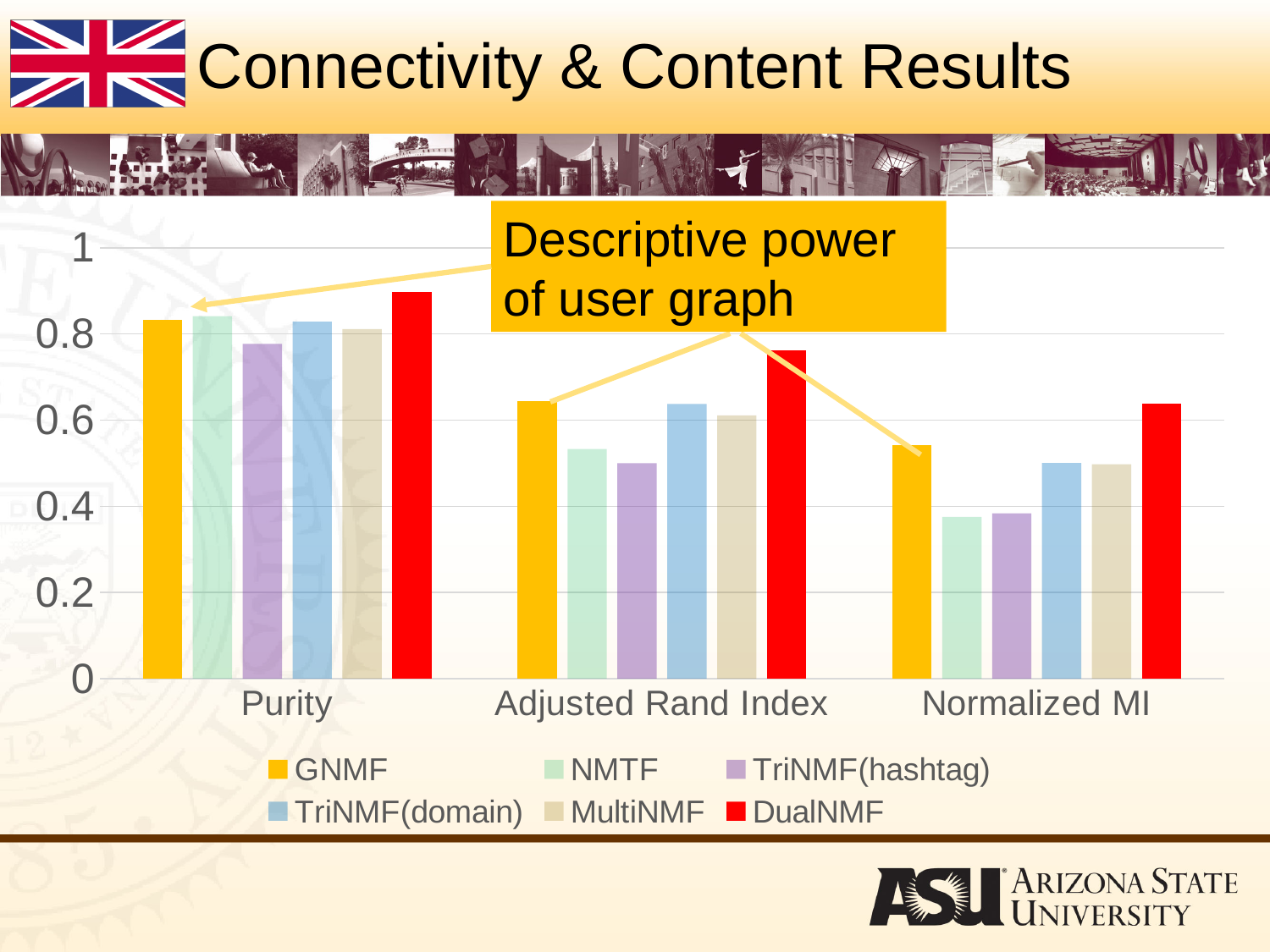
Is the value for DualNMF in the Adjusted Rand Index category greater or less than 0.6? greater How many series does the chart's legend list? 6 Is the value for NMTF in the Normalized MI category greater or less than 0.4? less For GNMF, which is larger: its value in the Purity category or its value in the Normalized MI category? Purity Which method has the highest bar in the Purity category? DualNMF What colour are the DualNMF bars in the chart? red How many categories are shown on the x axis of the chart? 3 In the Adjusted Rand Index category, which is larger: the value for DualNMF or the value for GNMF? DualNMF Is the value for DualNMF in the Purity category greater or less than 0.8? greater What kind of chart is shown on the slide? bar chart Which method has the highest bar in the Normalized MI category? DualNMF Which method has the highest bar in the Adjusted Rand Index category? DualNMF